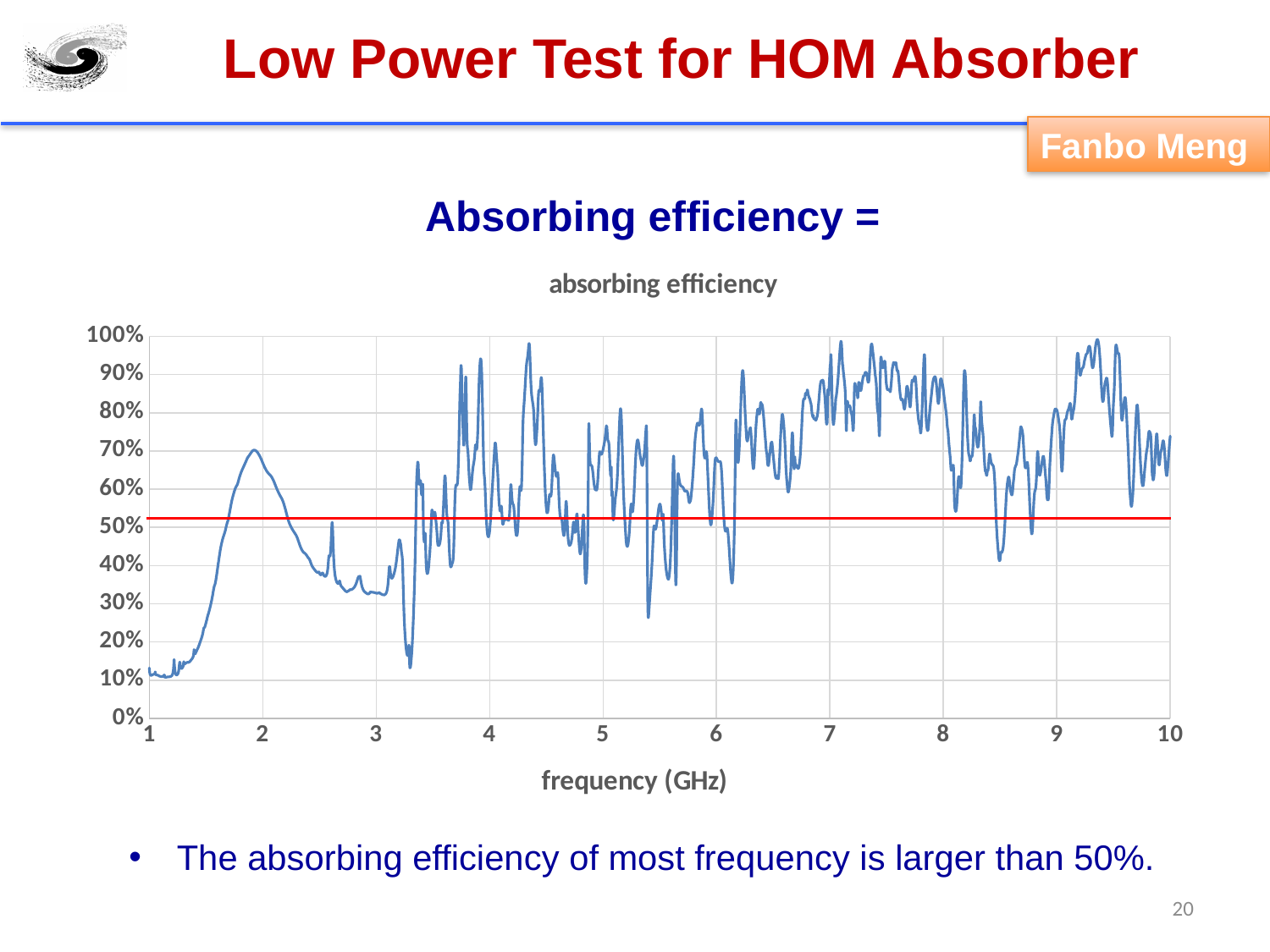
What is the title of the chart? absorbing efficiency Is the absorbing efficiency at 1 GHz greater or less than 20%? less What is the highest value shown on the y axis of the chart? 100% Does the absorbing efficiency rise or fall between 2 GHz and 3 GHz? fall Is the absorbing efficiency at 2 GHz greater or less than 50%? greater Is the absorbing efficiency at 3 GHz greater or less than 40%? less What kind of chart is shown on the slide? line chart Does the absorbing efficiency rise or fall between 1 GHz and 2 GHz? rise What is the label of the x axis of the chart? frequency (GHz) Is the absorbing efficiency at 1 GHz larger or smaller than at 2 GHz? smaller